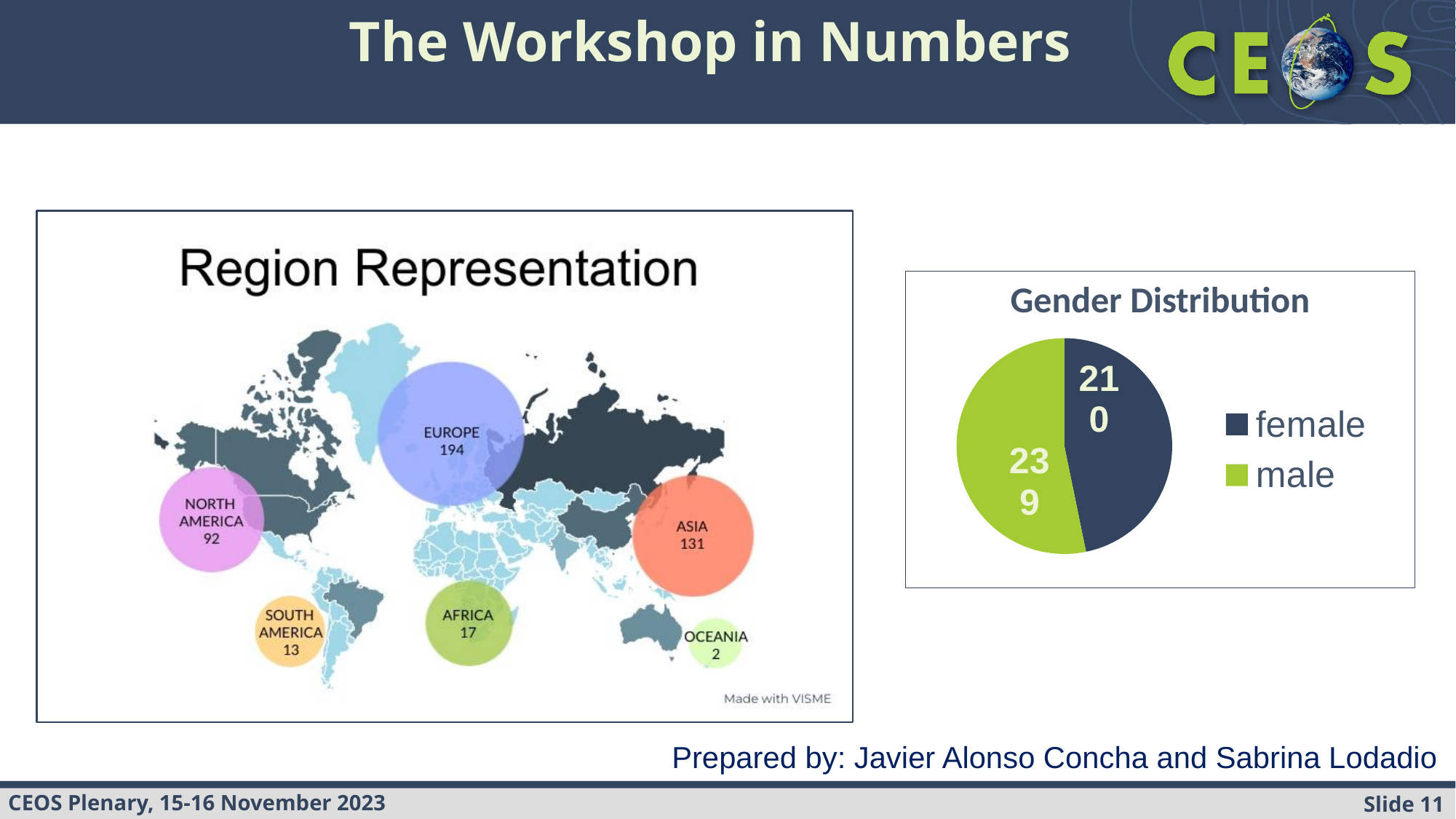
In the Region Representation chart, which region has the lowest value? Oceania In the Region Representation chart, which region has the highest value? Europe In the Region Representation chart, what is the difference between the values for North America and South America? 79 In the Region Representation chart, what is the value for Asia? 131 In the Gender Distribution pie chart, what is the value for male? 239 In the Gender Distribution pie chart, what is the difference between the male and female values? 29 In the Gender Distribution pie chart, what is the value for female? 210 In the Gender Distribution pie chart, which category is larger, female or male? male What kind of chart is the Gender Distribution chart? pie chart In the Region Representation chart, what is the value for Europe? 194 How many regions are shown in the Region Representation chart? 6 In the Gender Distribution chart, how many entries does the legend list? 2